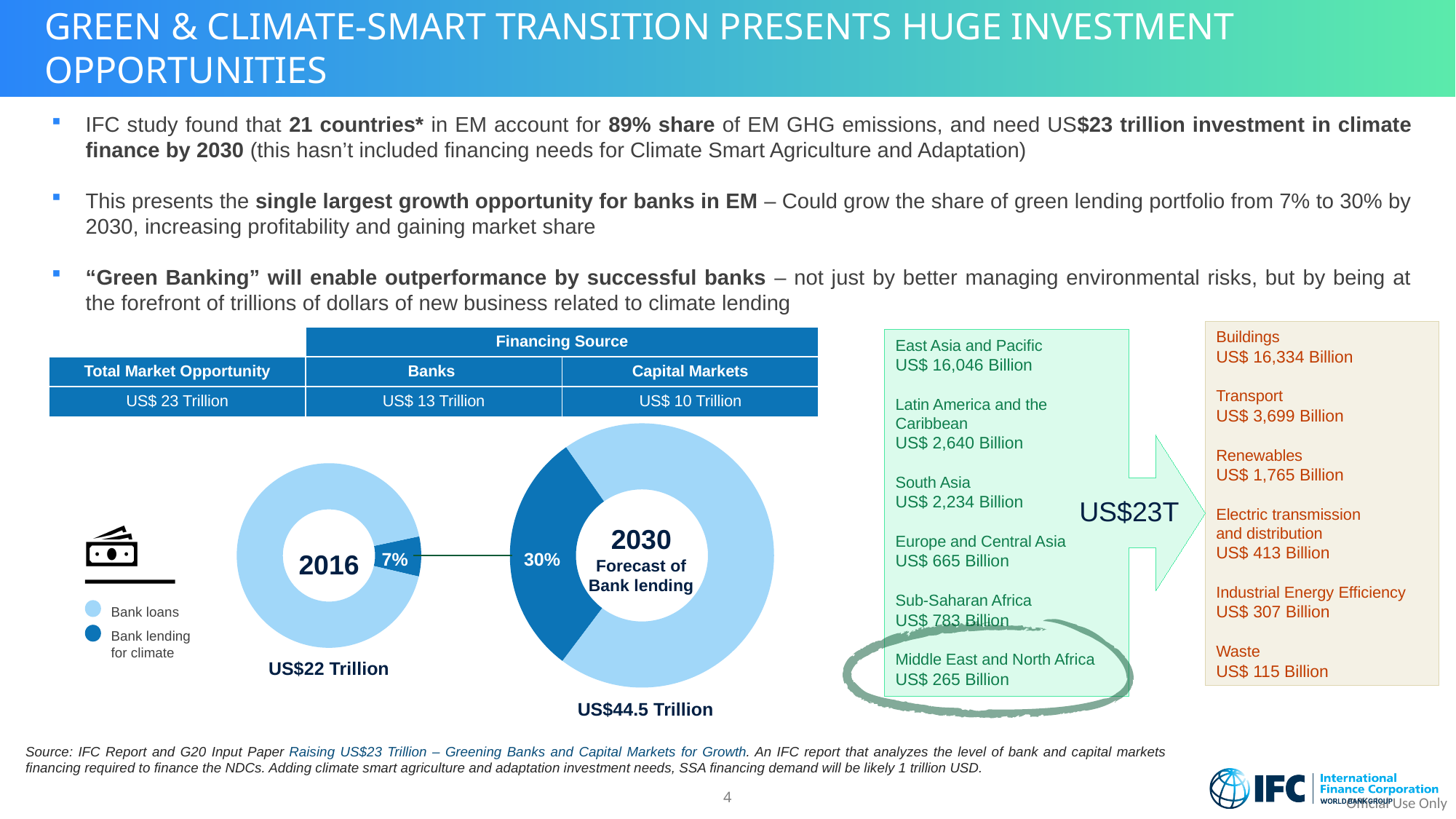
How many donut charts are shown on the slide? 2 In the legend next to the donut charts, which entry is shown in dark blue? Bank lending for climate Which donut chart shows the larger share for bank lending for climate, 2016 or 2030? 2030 How many entries does the legend next to the donut charts list? 2 By how many percentage points does the bank lending for climate share in the 2030 chart exceed that in the 2016 chart? 23 percentage points Does the share of bank lending for climate rise or fall from the 2016 chart to the 2030 chart? Rise What total value is printed beneath the 2030 Forecast of Bank lending donut chart? US$44.5 Trillion What kind of chart is used to show the 2016 and 2030 bank lending breakdowns? Pie (donut) chart What total value is printed beneath the 2016 donut chart? US$22 Trillion What text is printed in the centre of the right-hand donut chart? 2030 Forecast of Bank lending In the 2030 Forecast of Bank lending donut chart, what percentage is labelled for bank lending for climate? 30% In the 2016 donut chart, what percentage is labelled for bank lending for climate? 7%